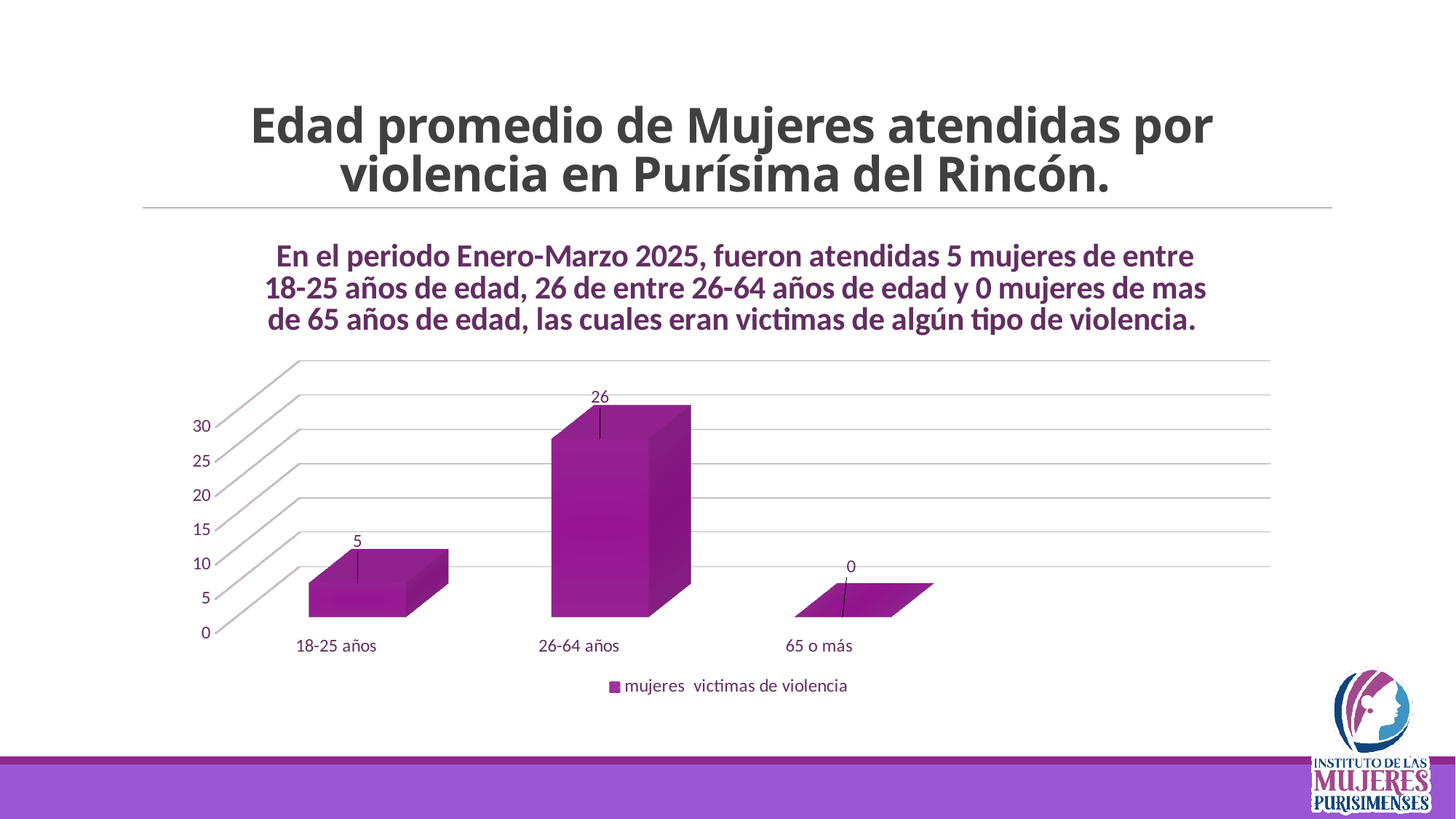
How many age categories are shown on the x axis? 3 Which age category has the highest value? 26-64 años Is the value for 26-64 años greater or less than 20? greater What is the value for the 18-25 años category? 5 How many series does the legend list? 1 What is the legend entry for the series shown in the chart? mujeres victimas de violencia What is the value for the 26-64 años category? 26 What is the value for the 65 o más category? 0 Which age category has the lowest value? 65 o más What is the difference between the values for 26-64 años and 18-25 años? 21 Which is larger, the value for 18-25 años or the value for 65 o más? 18-25 años What kind of chart is shown on the slide? bar chart